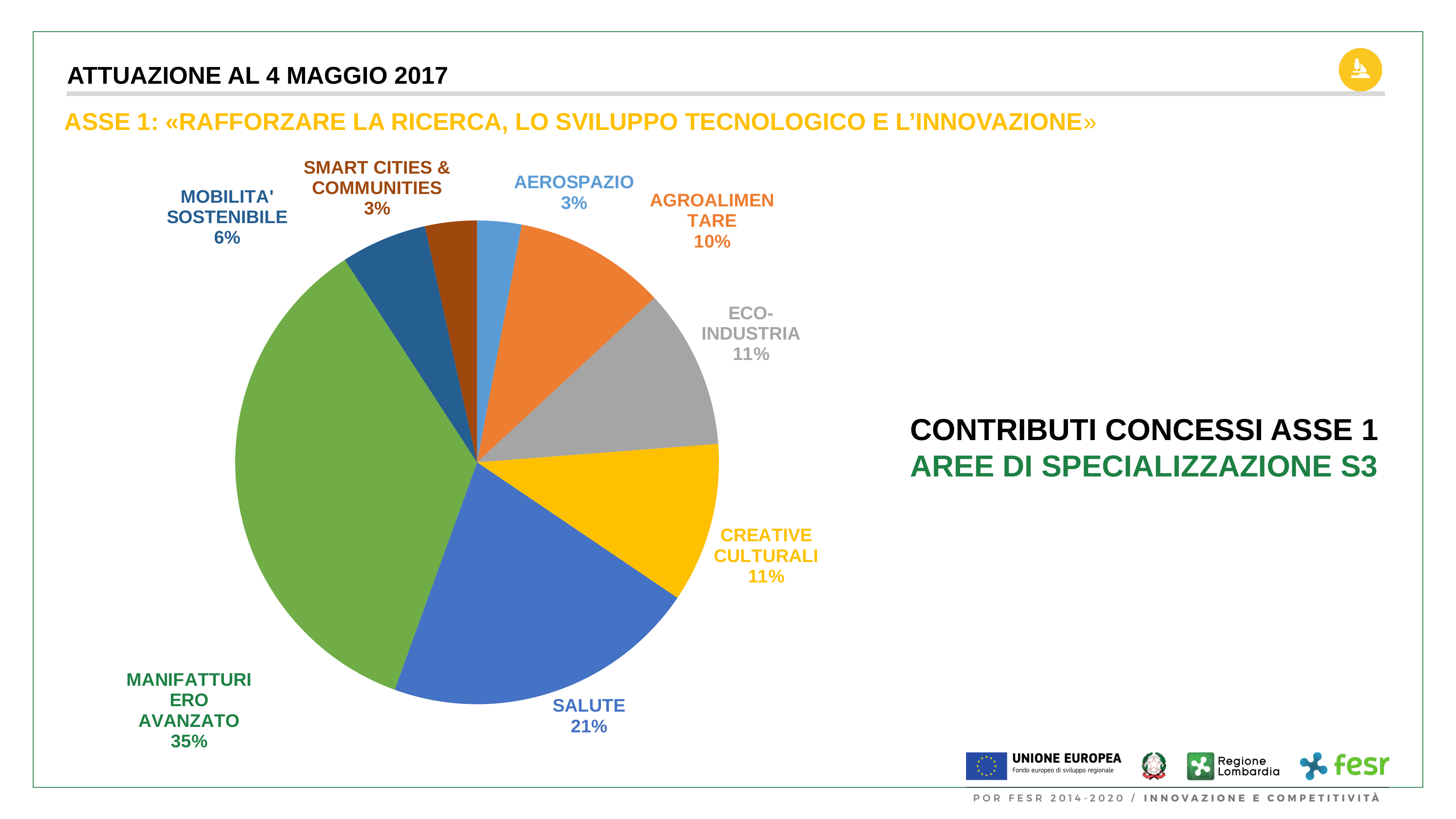
What is the value shown for MOBILITA' SOSTENIBILE? 6% What colour is the slice for MANIFATTURIERO AVANZATO? Green What kind of chart is shown on the slide? Pie chart Which is larger, the slice for ECO-INDUSTRIA or the slice for AGROALIMENTARE? ECO-INDUSTRIA How many categories are shown in the pie chart? 8 What is the value shown for CREATIVE CULTURALI? 11% What is the difference in percentage points between SALUTE and ECO-INDUSTRIA? 10 What is the value shown for AGROALIMENTARE? 10% What share of the pie does MANIFATTURIERO AVANZATO hold? 35% Which category has the largest slice of the pie? MANIFATTURIERO AVANZATO What is the difference in percentage points between MANIFATTURIERO AVANZATO and SALUTE? 14 What share of the pie does SALUTE hold? 21%